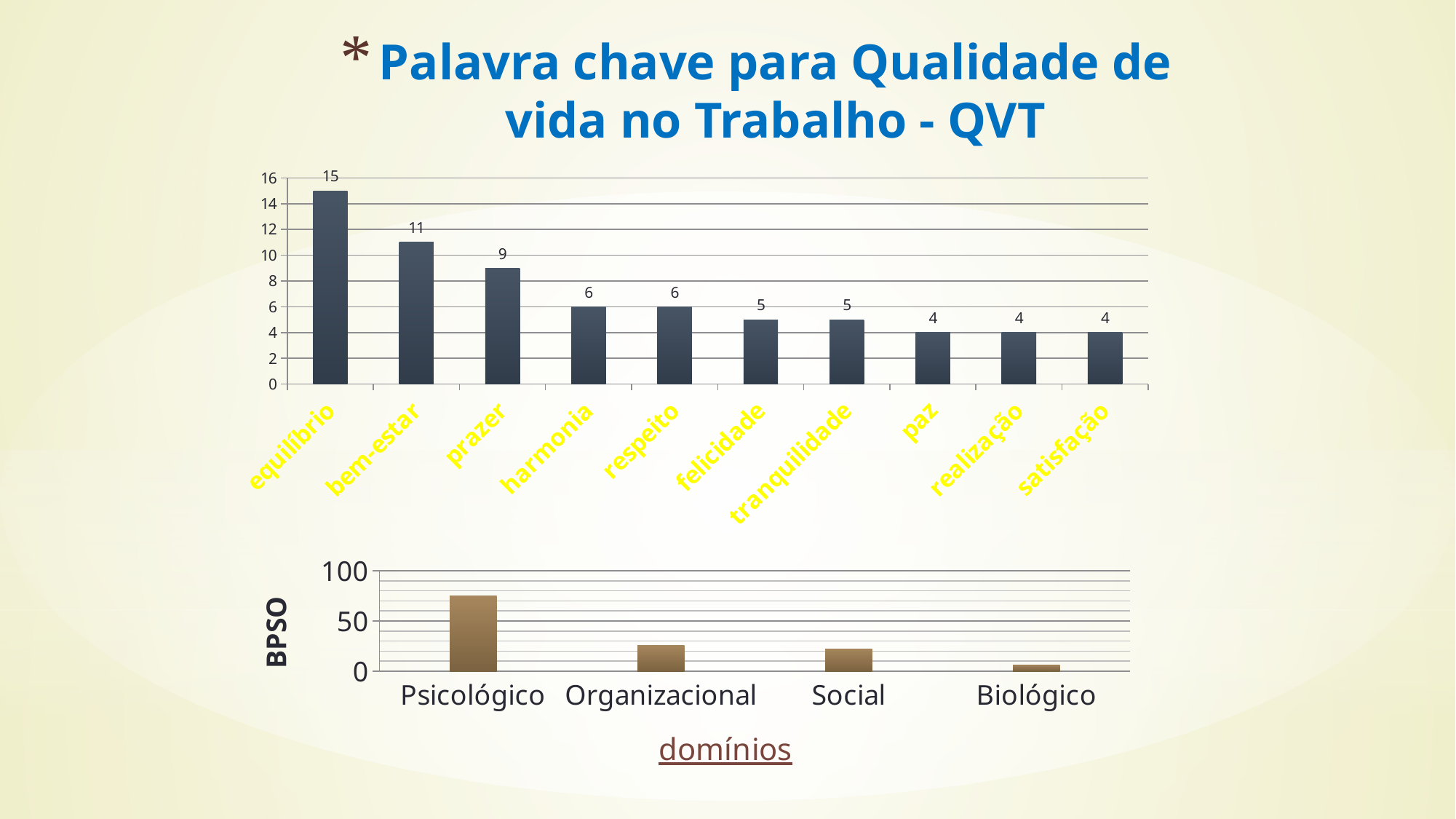
In the top chart, what is the difference between the values for equilíbrio and bem-estar? 4 In the bottom chart (BPSO by domínios), which domain has the highest value? Psicológico In the top chart, do the values rise or fall from left to right? fall In the bottom chart (BPSO by domínios), is the value for Psicológico greater or less than 50? greater In the top chart, what is the value for prazer? 9 In the top chart, how many keywords are plotted? 10 In the top chart, which keyword has the highest value? equilíbrio In the bottom chart (BPSO by domínios), which domain has the lowest value? Biológico What kind of chart is the top chart? bar chart In the bottom chart, what is the label on the vertical axis? BPSO In the top chart, which is larger, the value for harmonia or the value for felicidade? harmonia In the top chart, what is the value for equilíbrio? 15